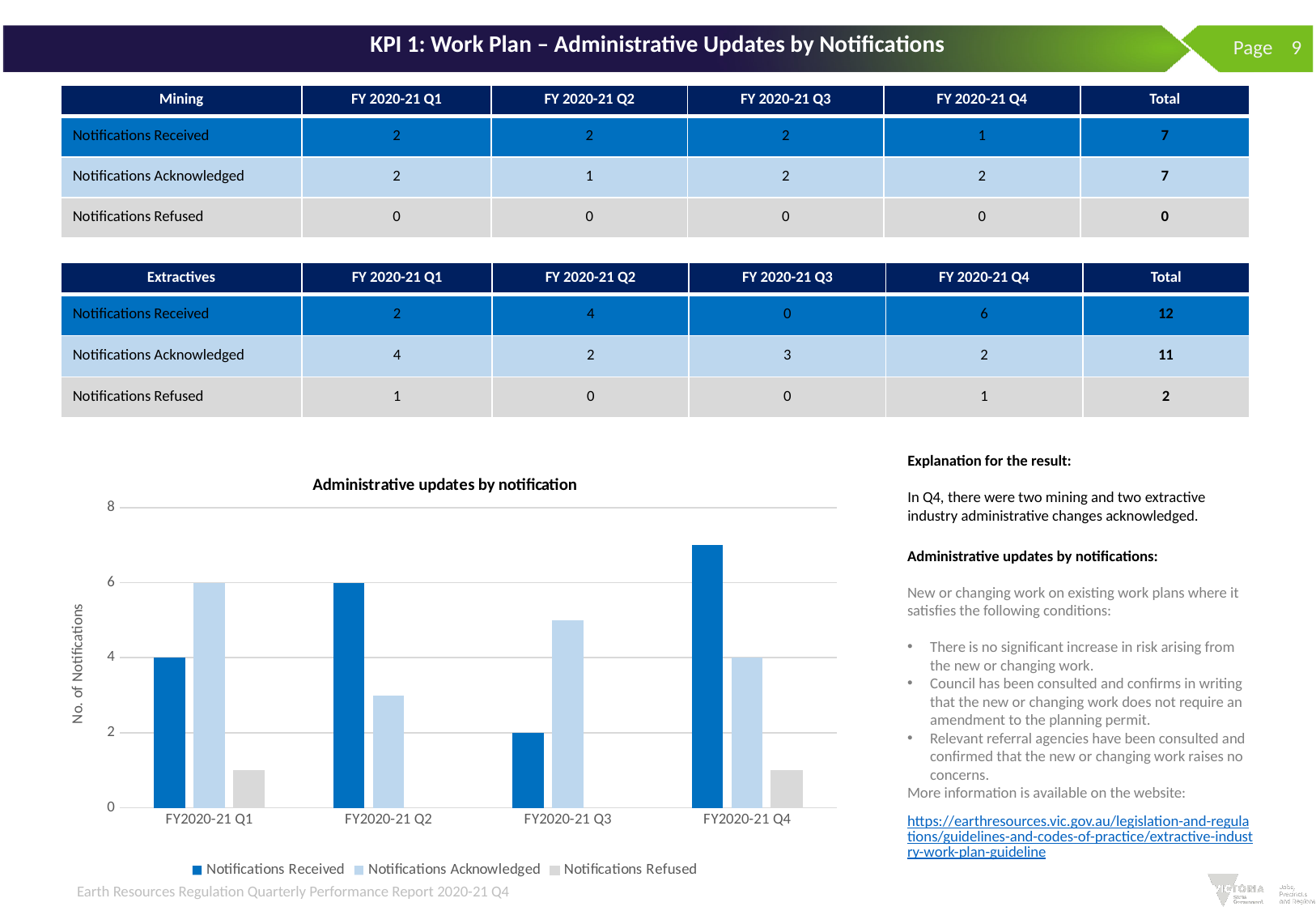
What is the value of Notifications Received for FY2020-21 Q3 in the chart? 2 How many quarters are shown on the x axis of the chart? 4 In which quarter is Notifications Received highest in the chart? FY2020-21 Q4 Is the value of Notifications Received for FY2020-21 Q4 greater or less than 6? greater In which quarter is Notifications Received lowest in the chart? FY2020-21 Q3 What kind of chart is shown on the slide? bar chart In FY2020-21 Q3, which is larger: Notifications Received or Notifications Acknowledged? Notifications Acknowledged What is the value of Notifications Acknowledged for FY2020-21 Q4 in the chart? 4 What is the value of Notifications Received for FY2020-21 Q1 in the chart? 4 What is the value of Notifications Acknowledged for FY2020-21 Q1 in the chart? 6 How many series does the legend of the chart list? 3 Is the value of Notifications Acknowledged for FY2020-21 Q2 greater or less than 4? less